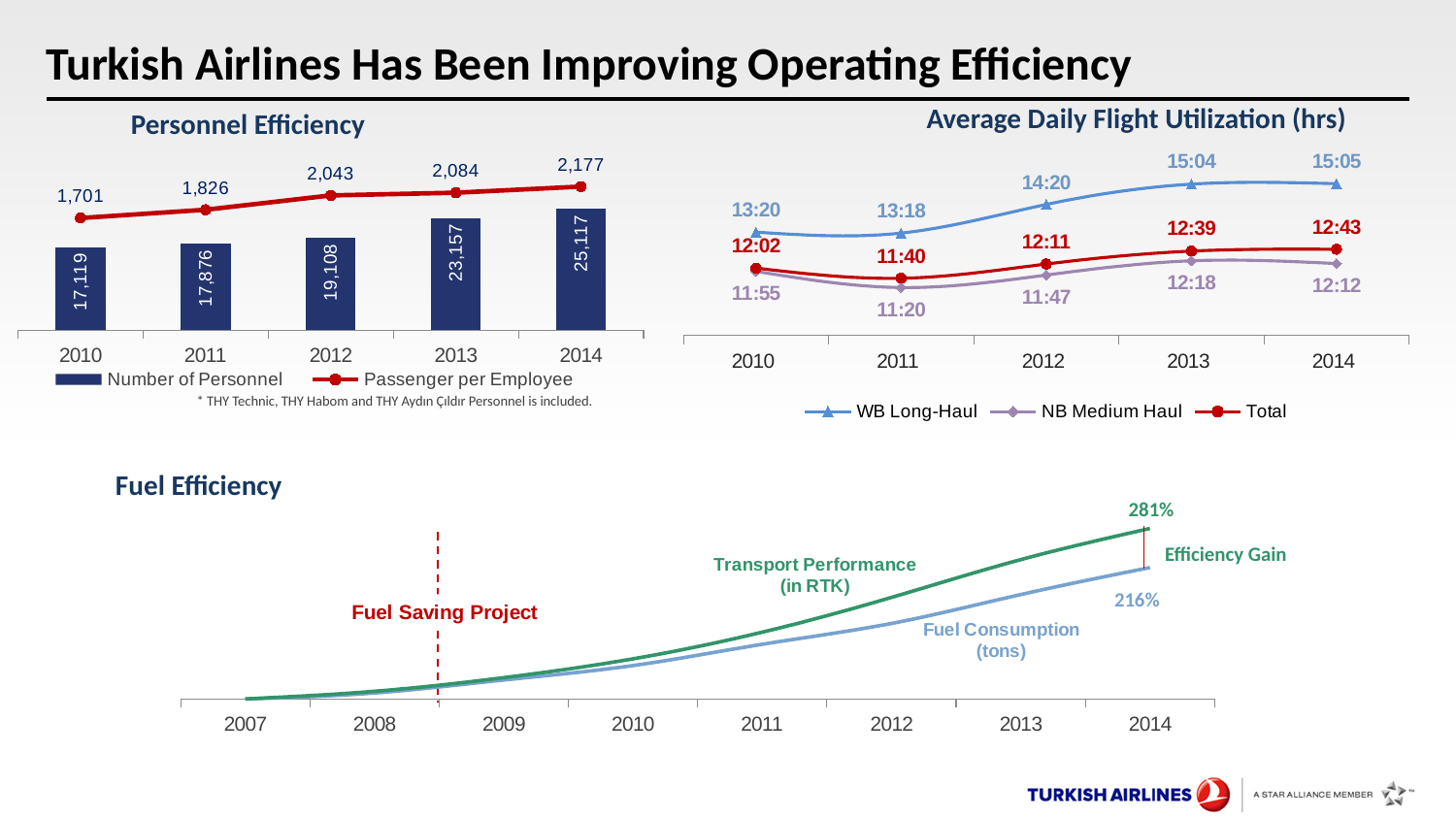
In the Personnel Efficiency chart, by how much did the Number of Personnel increase from 2012 to 2013? 4,049 In the Personnel Efficiency chart, what is the Number of Personnel in 2014? 25,117 In the Average Daily Flight Utilization chart, what is the NB Medium Haul value in 2011? 11:20 In the Personnel Efficiency chart, how many series does the legend list? 2 In the Personnel Efficiency chart, which year has the lowest Number of Personnel? 2010 In the Personnel Efficiency chart, does Passenger per Employee rise or fall from 2010 to 2014? rise In the Average Daily Flight Utilization chart, what is the WB Long-Haul value in 2013? 15:04 In the Fuel Efficiency chart, what value is labelled for Transport Performance (in RTK) in 2014? 281% In the Personnel Efficiency chart, what is the Passenger per Employee value in 2012? 2,043 In the Average Daily Flight Utilization chart, which year has the highest Total value? 2014 In the Average Daily Flight Utilization chart, which is larger in 2012: WB Long-Haul or NB Medium Haul? WB Long-Haul In the Average Daily Flight Utilization chart, how many years are shown on the x axis? 5